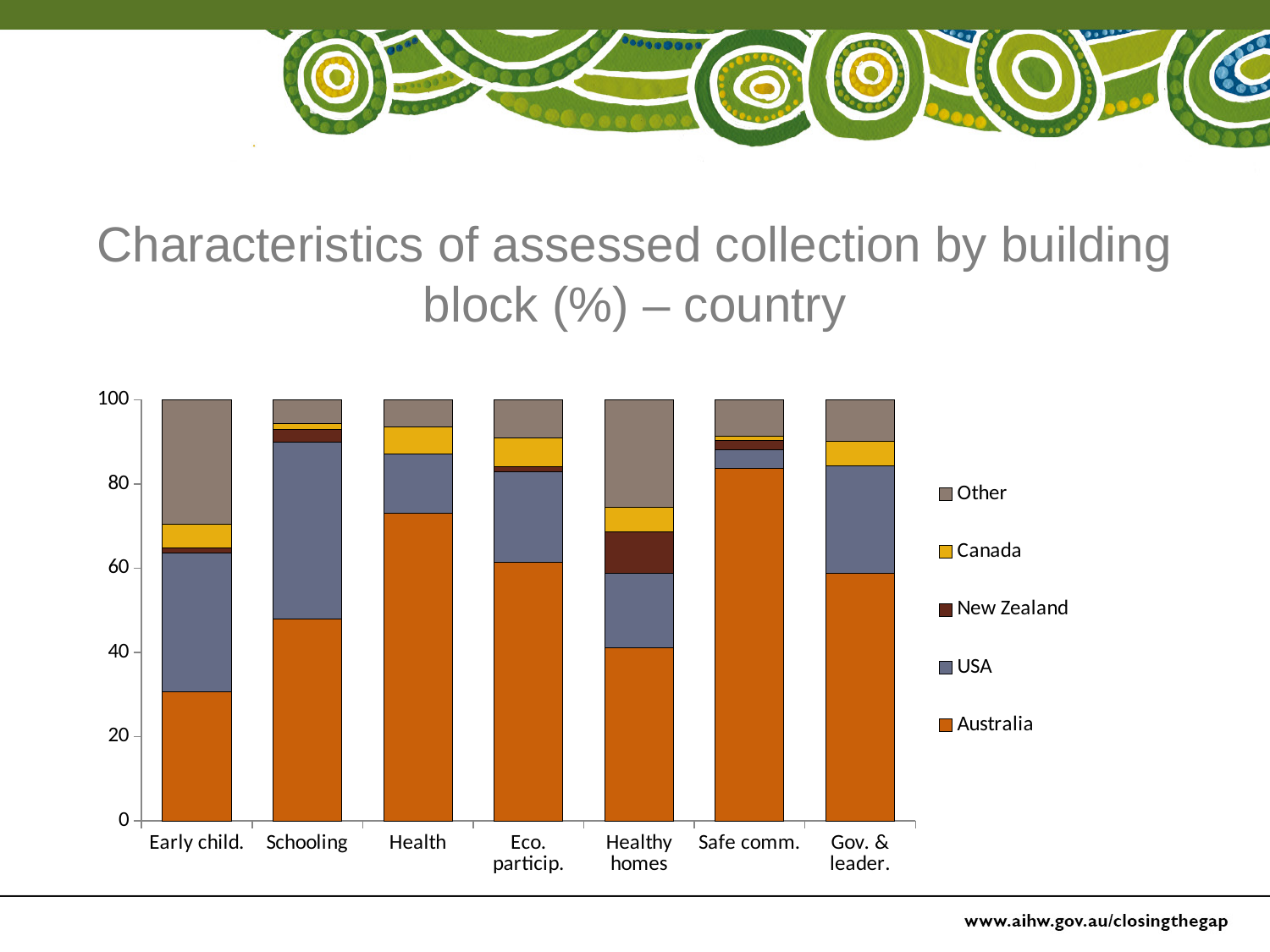
How many building block categories are shown on the x axis? 7 Which has the larger Australia segment, Health or Schooling? Health Is the Australia value for Safe comm. greater or less than 80? greater Is the Australia value for Health greater or less than 60? greater How many series does the legend list? 5 What kind of chart is shown on the slide? stacked bar chart Which category has the largest Australia segment? Safe comm. Which category has the smallest Australia segment? Early child. Which category has the largest New Zealand segment? Healthy homes Which category has the largest Other segment? Early child. Is the Australia value for Early child. greater or less than 40? less What is the total height of each stacked bar? 100